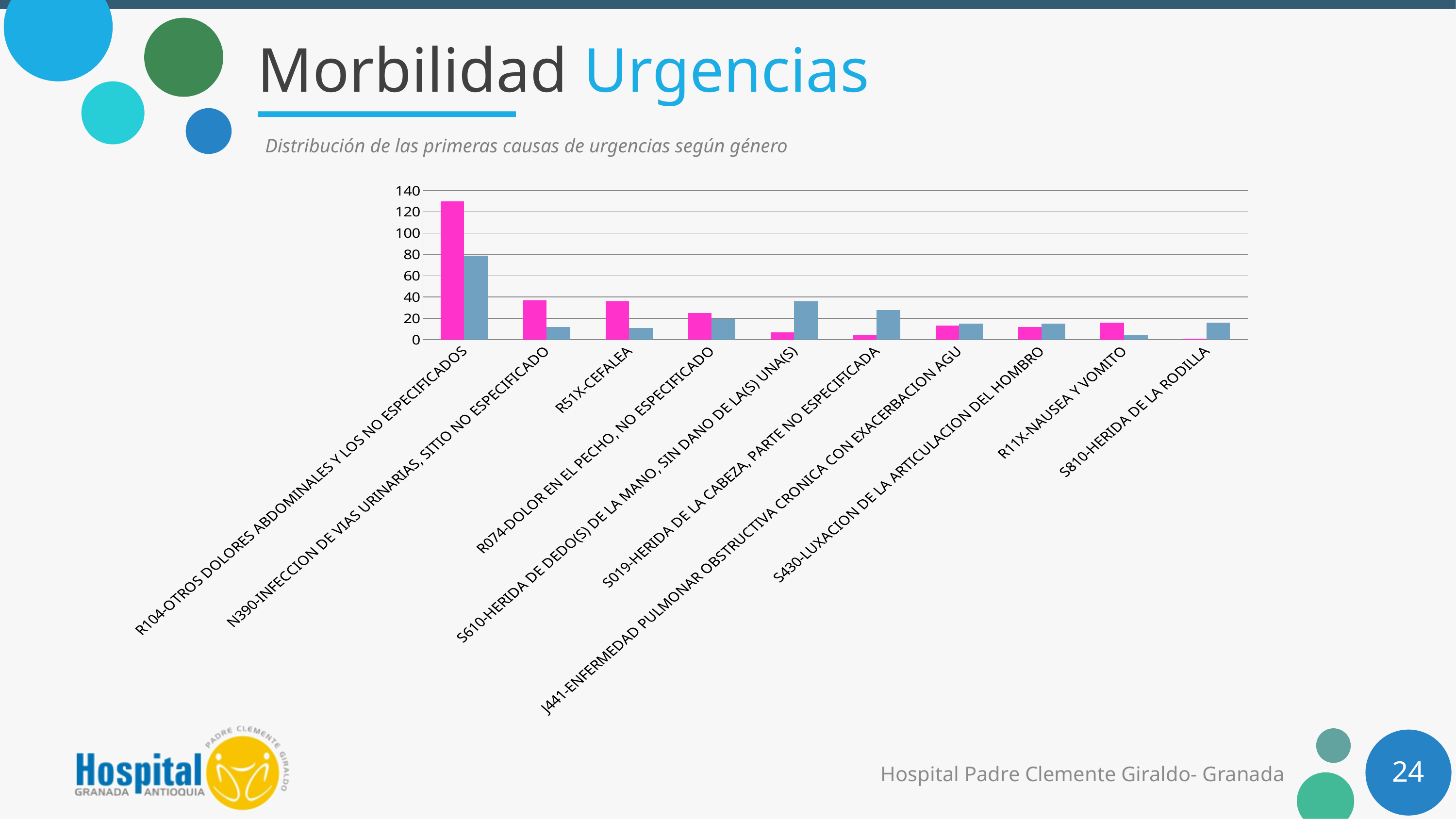
Which category has the tallest blue bar in the chart? R104-OTROS DOLORES ABDOMINALES Y LOS NO ESPECIFICADOS What kind of chart is shown on the slide? bar chart Is the pink bar for N390-INFECCION DE VIAS URINARIAS, SITIO NO ESPECIFICADO greater or less than 40? less Which category has the shortest blue bar in the chart? R11X-NAUSEA Y VOMITO Is the blue bar for S610-HERIDA DE DEDO(S) DE LA MANO, SIN DANO DE LA(S) UNA(S) greater or less than 20? greater Which category has the shortest pink bar in the chart? S810-HERIDA DE LA RODILLA For R11X-NAUSEA Y VOMITO, which bar is taller, the pink one or the blue one? the pink one How many bars are plotted for each category in the chart? 2 For S019-HERIDA DE LA CABEZA, PARTE NO ESPECIFICADA, which bar is taller, the pink one or the blue one? the blue one How many categories (diagnoses) are shown on the x axis of the chart? 10 Is the pink bar for R104-OTROS DOLORES ABDOMINALES Y LOS NO ESPECIFICADOS greater or less than 120? greater Which category has the tallest pink bar in the chart? R104-OTROS DOLORES ABDOMINALES Y LOS NO ESPECIFICADOS